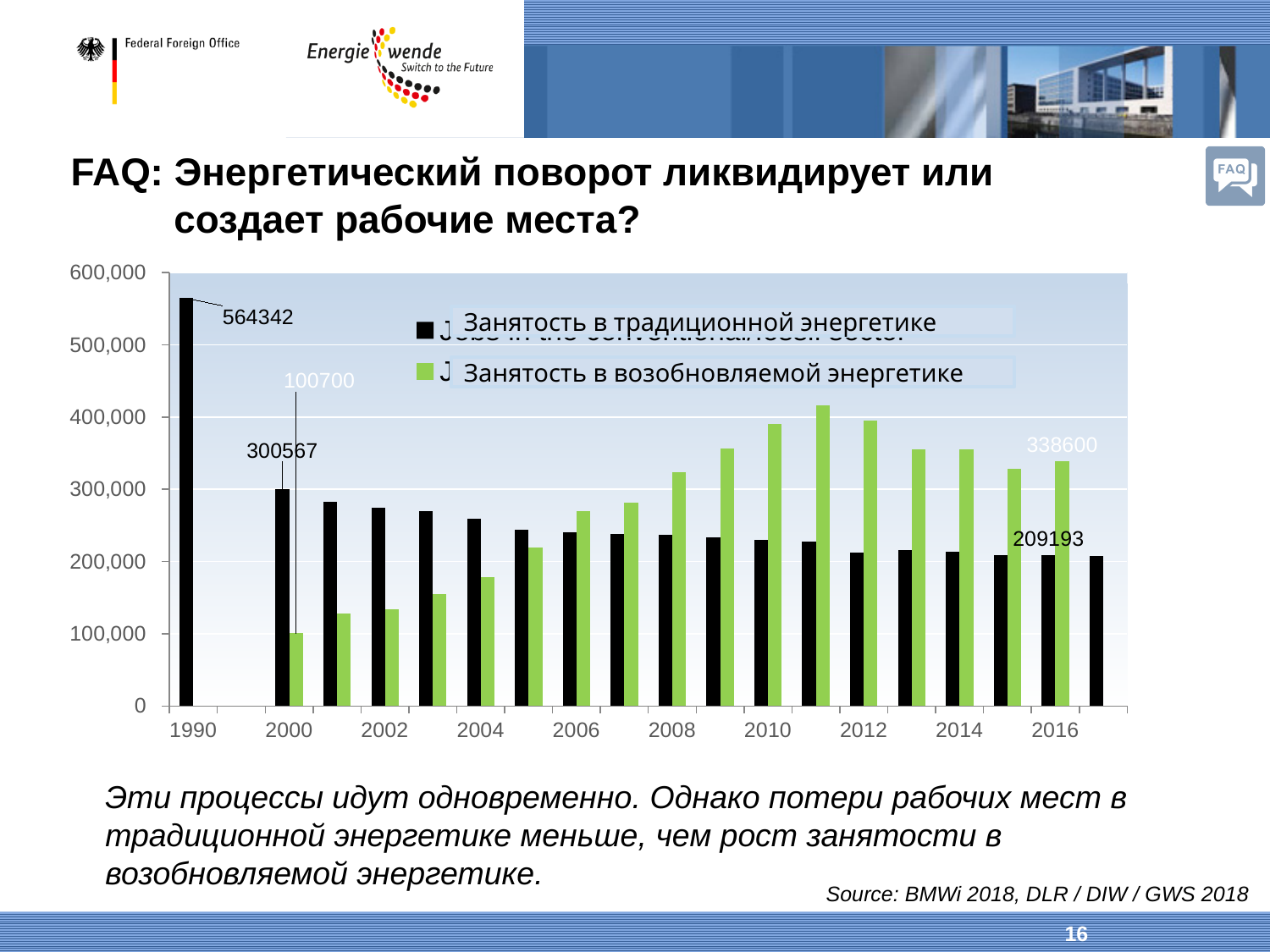
How many series does the legend list? 2 What is the value for employment in renewable energy (Занятость в возобновляемой энергетике) in 2000? 100700 In 2016, which series has the larger value: conventional energy or renewable energy employment? Renewable energy employment Does conventional energy employment rise or fall from 2000 to 2016? fall Is the value for renewable energy employment in 2011 greater or less than 400,000? greater In 2016, how much larger is renewable energy employment than conventional energy employment? 129407 What is the value for employment in renewable energy in 2016? 338600 What is the value for employment in conventional energy (Занятость в традиционной энергетике) in 1990? 564342 What is the value for employment in conventional energy in 2016? 209193 In which year is renewable energy employment highest? 2011 What is the value for employment in conventional energy in 2000? 300567 By how much did conventional energy employment fall between 1990 and 2000? 263775